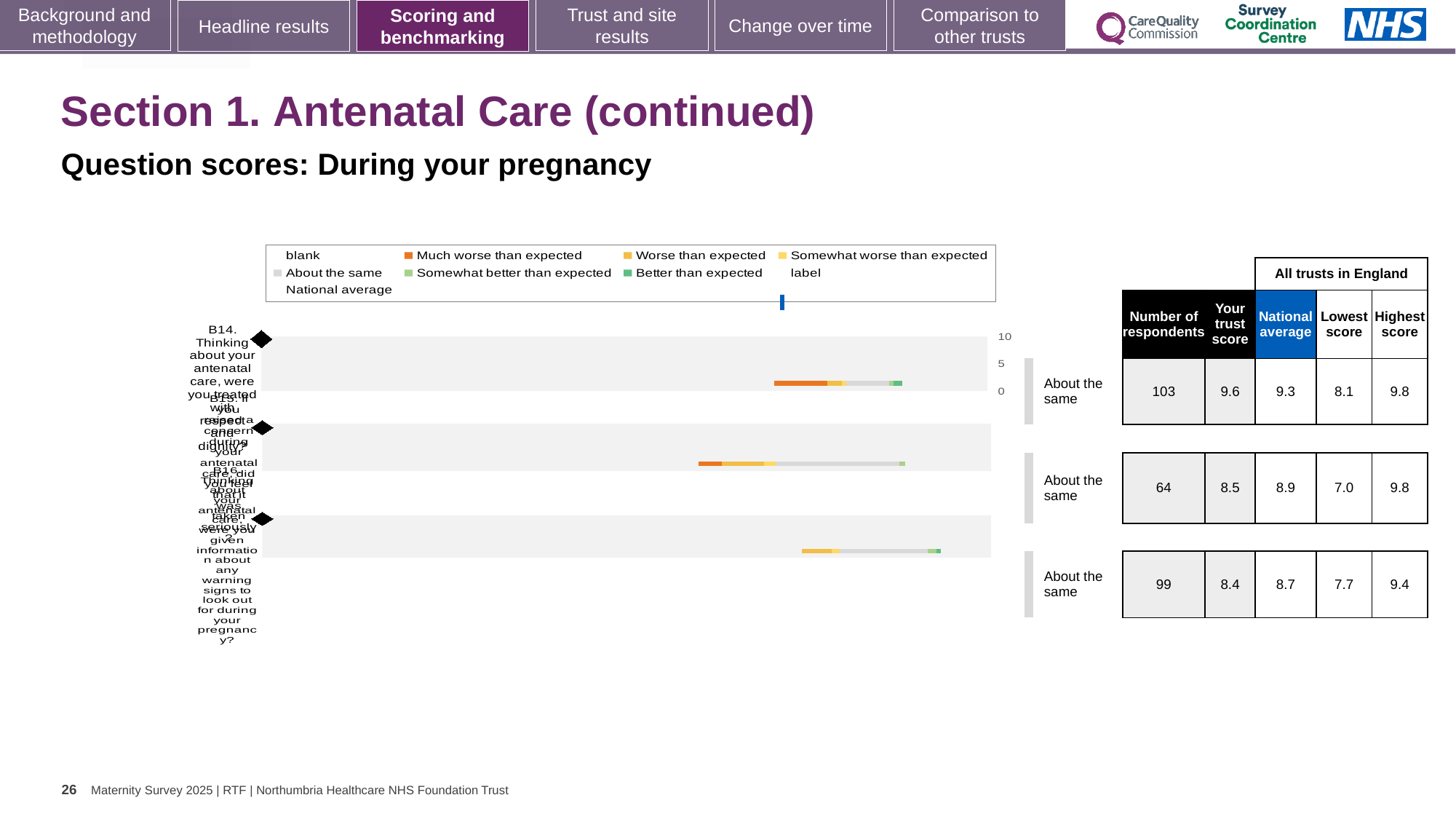
For question B14, what is the difference between the trust score and the national average? 0.3 What is the benchmark category shown beside the chart for question B14 (treated with respect and dignity)? About the same In the table beside the chart, what is the trust score for question B14 (treated with respect and dignity)? 9.6 Which question row has the highest number of respondents in the table beside the chart? B14 (treated with respect and dignity), 103 How many survey questions (rows) are plotted in the chart? 3 What kind of chart is shown on the slide? bar chart In the table beside the chart, what is the trust score for the second question row? 8.5 For question B14, which is larger: the trust score or the national average? the trust score In the table beside the chart, what is the number of respondents for question B14 (treated with respect and dignity)? 103 What colour does the legend use for "Much worse than expected"? orange In the table beside the chart, what is the highest score in England for the third question row? 9.4 In the table beside the chart, what is the national average for question B14 (treated with respect and dignity)? 9.3